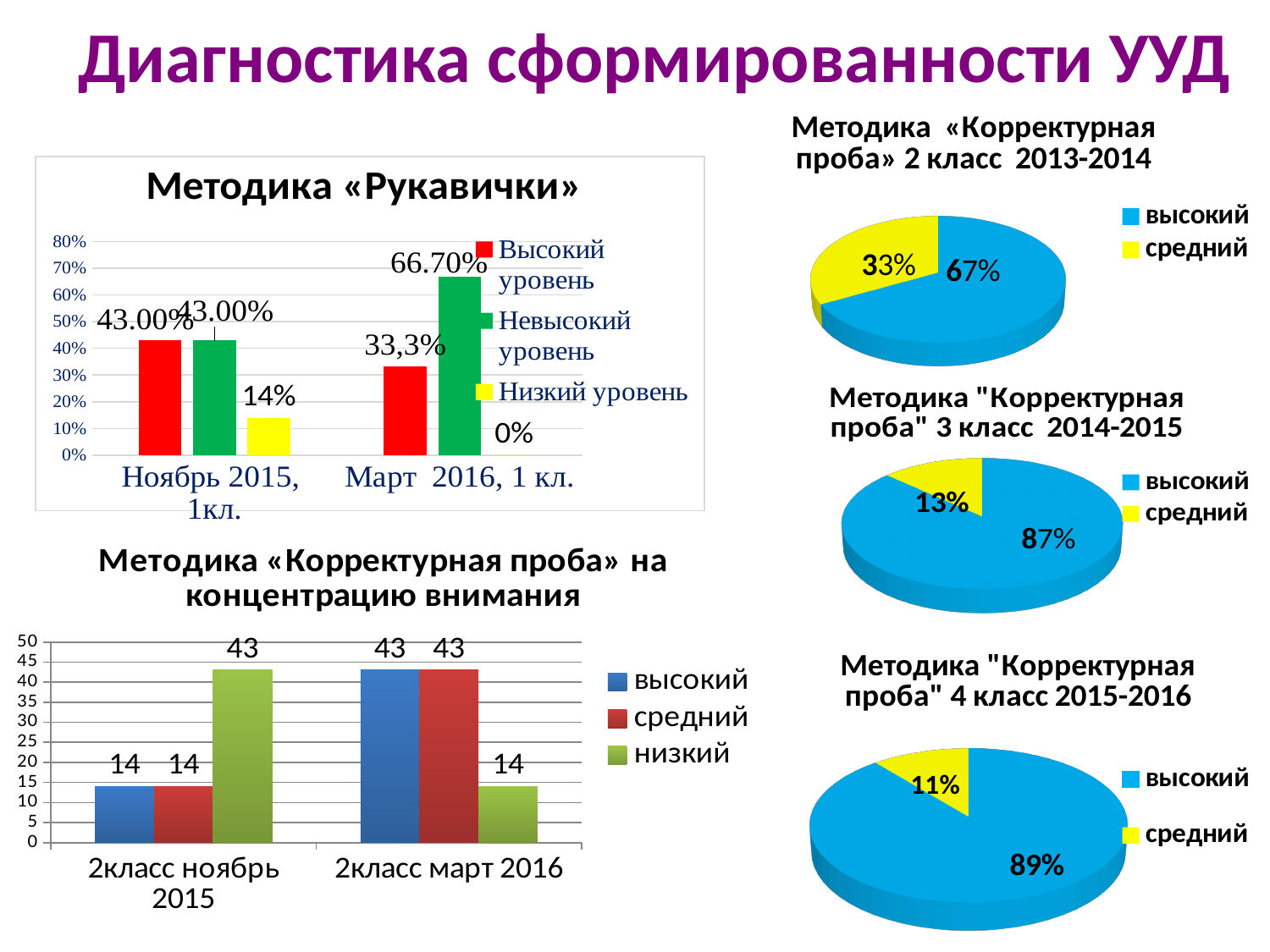
In the chart "Методика «Корректурная проба» на концентрацию внимания", which series has the lowest value in 2класс март 2016? низкий In the chart "Методика «Рукавички»", what is the value for Высокий уровень in Март 2016, 1 кл.? 33,3% In the chart "Методика «Рукавички»", what is the value for Низкий уровень in Ноябрь 2015, 1кл.? 14% In the pie chart "Методика «Корректурная проба» 2 класс 2013-2014", what share does средний have? 33% In the pie chart "Методика "Корректурная проба" 4 класс 2015-2016", what is the difference between the высокий and средний shares? 78% In the chart "Методика «Рукавички»", how many series does the legend list? 3 What kind of chart is "Методика «Корректурная проба» на концентрацию внимания"? bar chart In the chart "Методика «Корректурная проба» на концентрацию внимания", what is the value for низкий in 2класс ноябрь 2015? 43 In the pie chart "Методика "Корректурная проба" 4 класс 2015-2016", which slice is larger, высокий or средний? высокий In the pie chart "Методика "Корректурная проба" 3 класс 2014-2015", what share does высокий have? 87% In the chart "Методика «Корректурная проба» на концентрацию внимания", what is the difference between высокий in 2класс март 2016 and высокий in 2класс ноябрь 2015? 29 In the chart "Методика «Рукавички»", what is the value for Невысокий уровень in Март 2016, 1 кл.? 66.70%